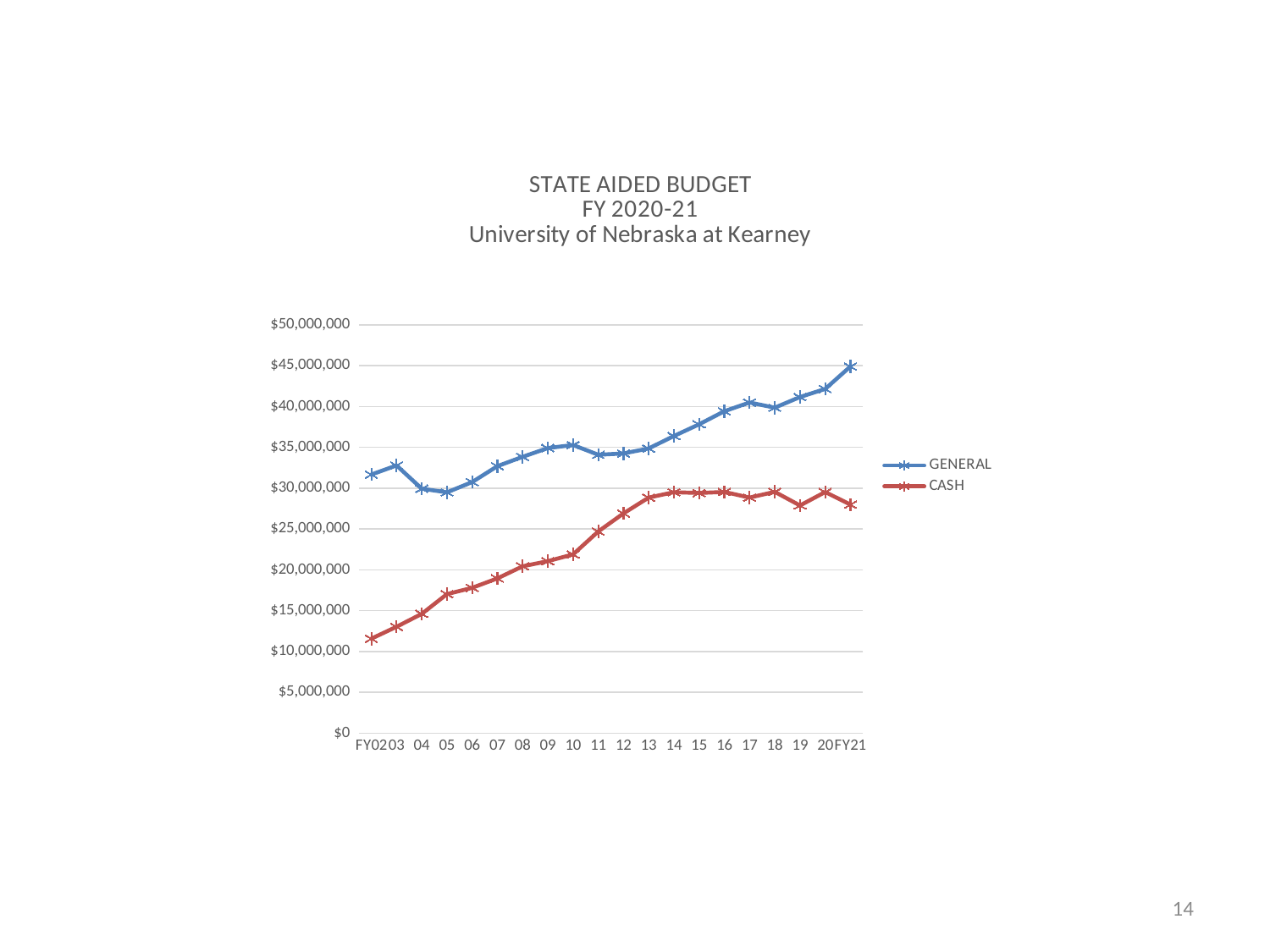
In which fiscal year is the GENERAL series at its highest? FY21 Which two series are listed in the legend? GENERAL and CASH What kind of chart is shown on the slide? line chart Is the CASH value for FY0203 greater or less than $15,000,000? less Does the CASH series overall rise or fall from FY0203 to FY21? rise How many series does the legend list? 2 Is the CASH value for 13 greater or less than $25,000,000? greater In which fiscal year is the CASH series at its lowest? FY02 How many fiscal years are plotted along the x axis? 20 Is the GENERAL value for FY21 greater or less than $40,000,000? greater Which series has the larger value in FY21, GENERAL or CASH? GENERAL